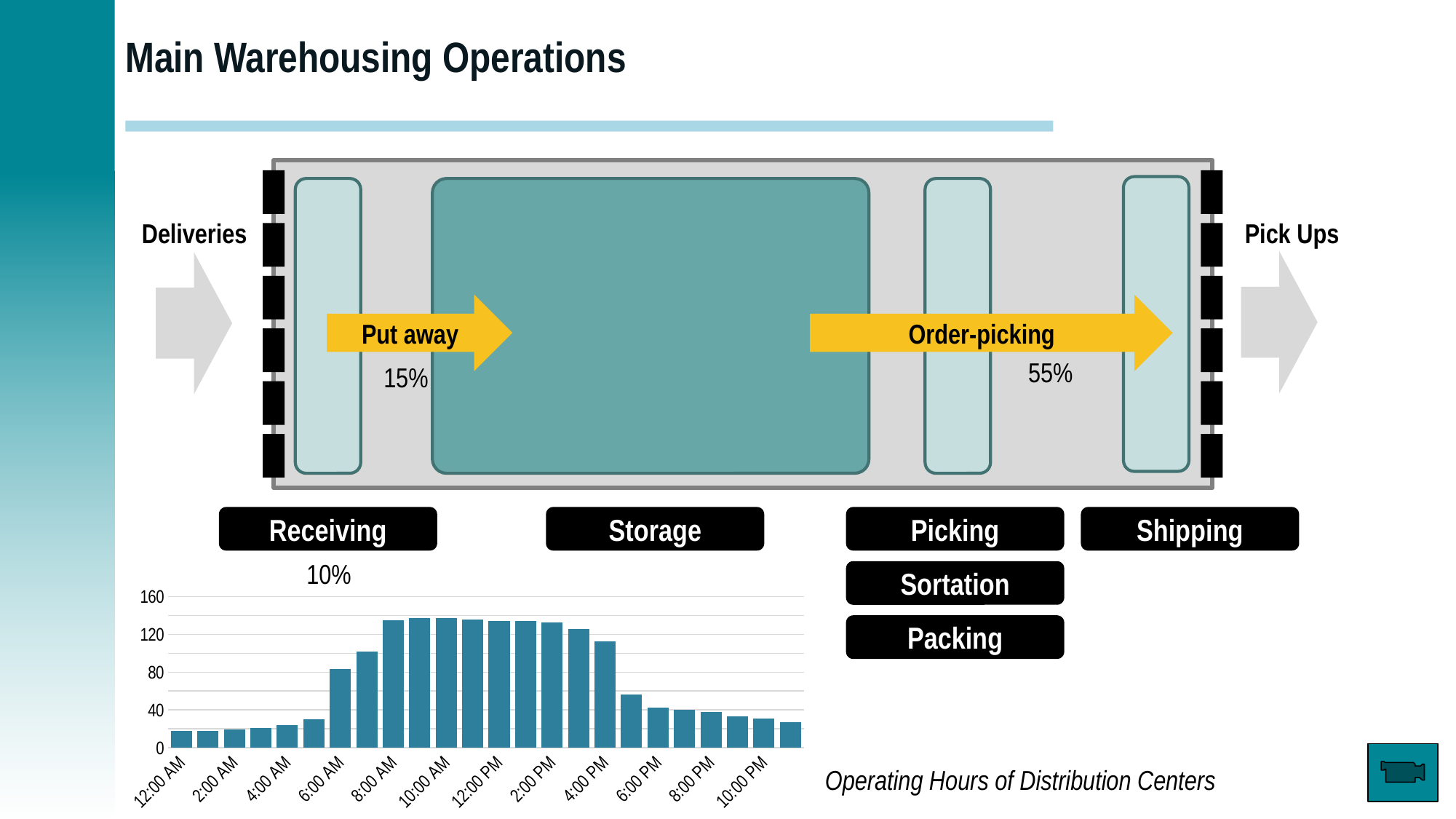
In the Operating Hours of Distribution Centers chart, do the values rise or fall from 12:00 AM to 10:00 AM? rise How many bars does the Operating Hours of Distribution Centers chart contain? 24 In the Operating Hours of Distribution Centers chart, is the value for 12:00 AM greater or less than 40? less In the Operating Hours of Distribution Centers chart, is the value for 2:00 PM greater or less than 120? greater In the Operating Hours of Distribution Centers chart, is the value for 10:00 PM greater or less than 40? less In the Operating Hours of Distribution Centers chart, which is larger, the value for 12:00 AM or the value for 12:00 PM? 12:00 PM What is the highest value shown on the vertical axis of the Operating Hours of Distribution Centers chart? 160 What kind of chart is shown at the bottom left of the slide? bar chart In the Operating Hours of Distribution Centers chart, do the values rise or fall from 2:00 PM to 10:00 PM? fall In the Operating Hours of Distribution Centers chart, which is larger, the value for 8:00 AM or the value for 6:00 PM? 8:00 AM